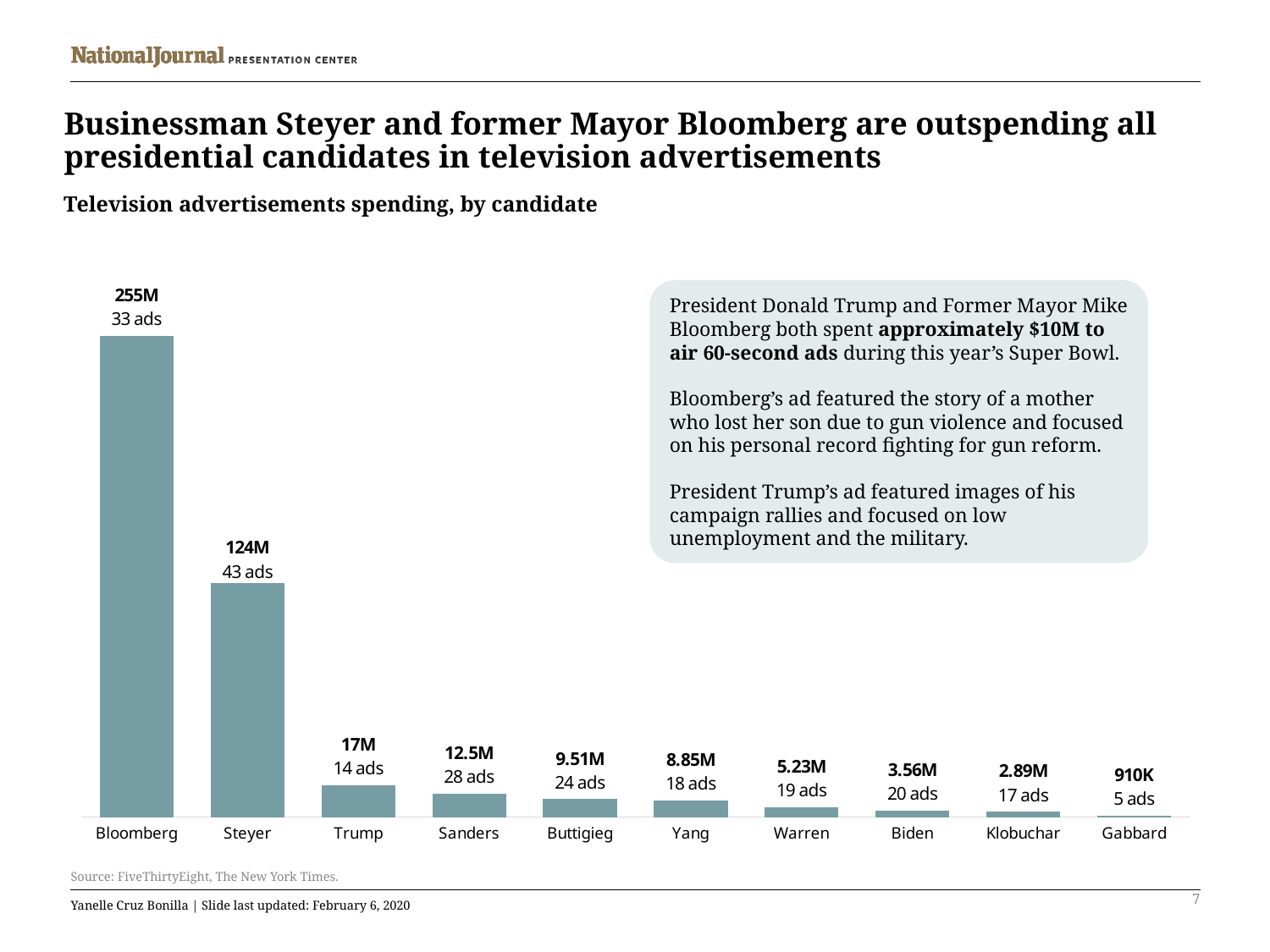
What kind of chart is used to show television advertisement spending by candidate? Bar chart What is the subtitle of the chart? Television advertisements spending, by candidate What is the television advertisement spending shown for Bloomberg? 255M Do the spending values rise or fall moving from left to right across the candidates? Fall How many ads does the chart show for Steyer? 43 ads What is the spending value shown for Gabbard? 910K Which candidate has the highest television advertisement spending? Bloomberg What is the spending value shown for Sanders? 12.5M Which candidate spent more on television advertisements, Trump or Sanders? Trump What is the difference in spending between Bloomberg and Steyer? 131M How many candidates are shown in the chart? 10 Which candidate has the lowest television advertisement spending? Gabbard